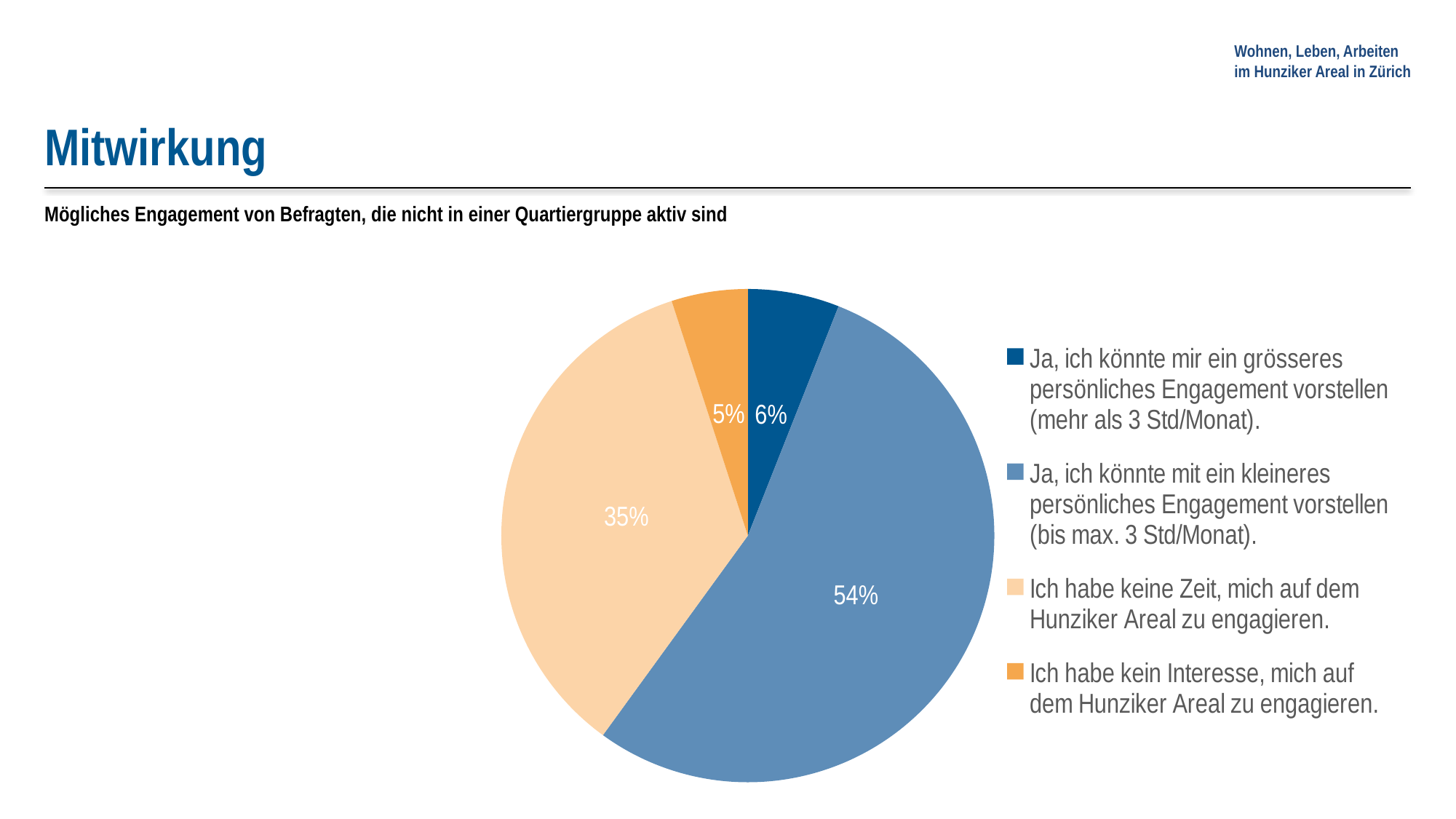
What share of respondents said they have no time to engage on the Hunziker Areal ("Ich habe keine Zeit...")? 35% How many entries does the legend list? 4 What share of respondents could imagine a larger personal engagement (more than 3 Std/Monat)? 6% Which category has the smallest share of the pie? Ich habe kein Interesse, mich auf dem Hunziker Areal zu engagieren. What share of respondents could imagine a smaller personal engagement (up to max. 3 Std/Monat)? 54% What is the difference in percentage points between the "kleineres Engagement" slice and the "keine Zeit" slice? 19 What kind of chart is shown on the slide? pie chart What share of respondents said they have no interest in engaging on the Hunziker Areal? 5% Which is larger: the share for "grösseres persönliches Engagement" or the share for "kein Interesse"? grösseres persönliches Engagement (6%) How many slices does the pie chart have? 4 Which category has the largest share of the pie? Ja, ich könnte mit ein kleineres persönliches Engagement vorstellen (bis max. 3 Std/Monat). What colour is the slice representing "Ich habe kein Interesse, mich auf dem Hunziker Areal zu engagieren."? orange